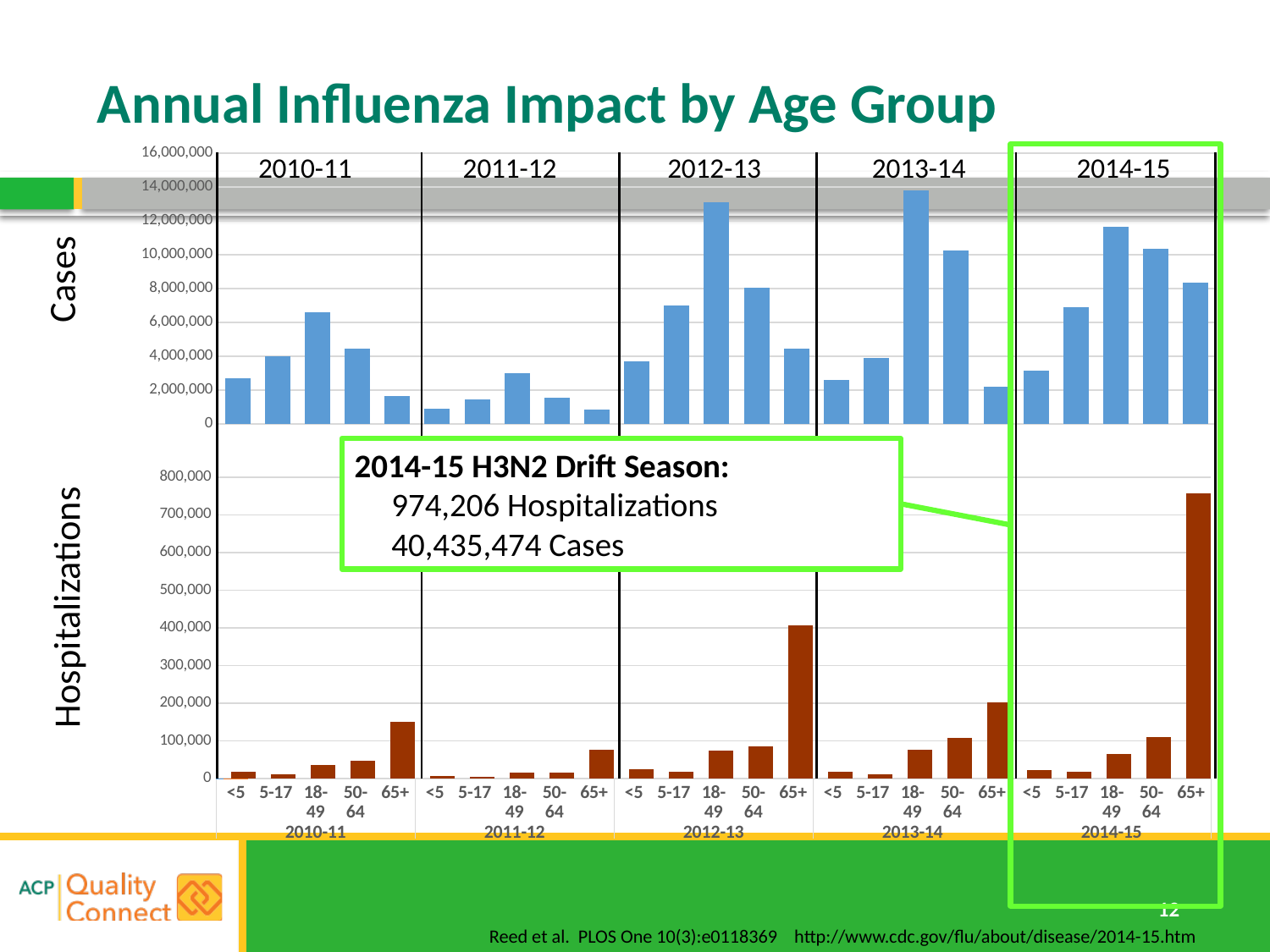
How many bars are plotted in the Cases chart in total? 25 In the Hospitalizations chart, which season and age group has the highest bar? 2014-15, 65+ In the Cases chart, do the values rise or fall from the 18-49 group to the 65+ group within the 2014-15 season? fall In the Hospitalizations chart, which is larger: 65+ in 2012-13 or 65+ in 2014-15? 65+ in 2014-15 What kind of chart is used for the Cases panel at the top of the slide? Bar chart In the Cases chart, is the value for 18-49 in 2011-12 greater or less than 4,000,000? less According to the callout box on the slide, how many hospitalizations occurred in the 2014-15 H3N2 drift season? 974,206 In the Cases chart, is the value for 18-49 in 2013-14 greater or less than 12,000,000? greater How many flu seasons are shown along the x axis of the Hospitalizations chart? 5 In the Hospitalizations chart, is the value for 65+ in 2014-15 greater or less than 700,000? greater In the Cases chart, which age group has the highest value within the 2014-15 season? 18-49